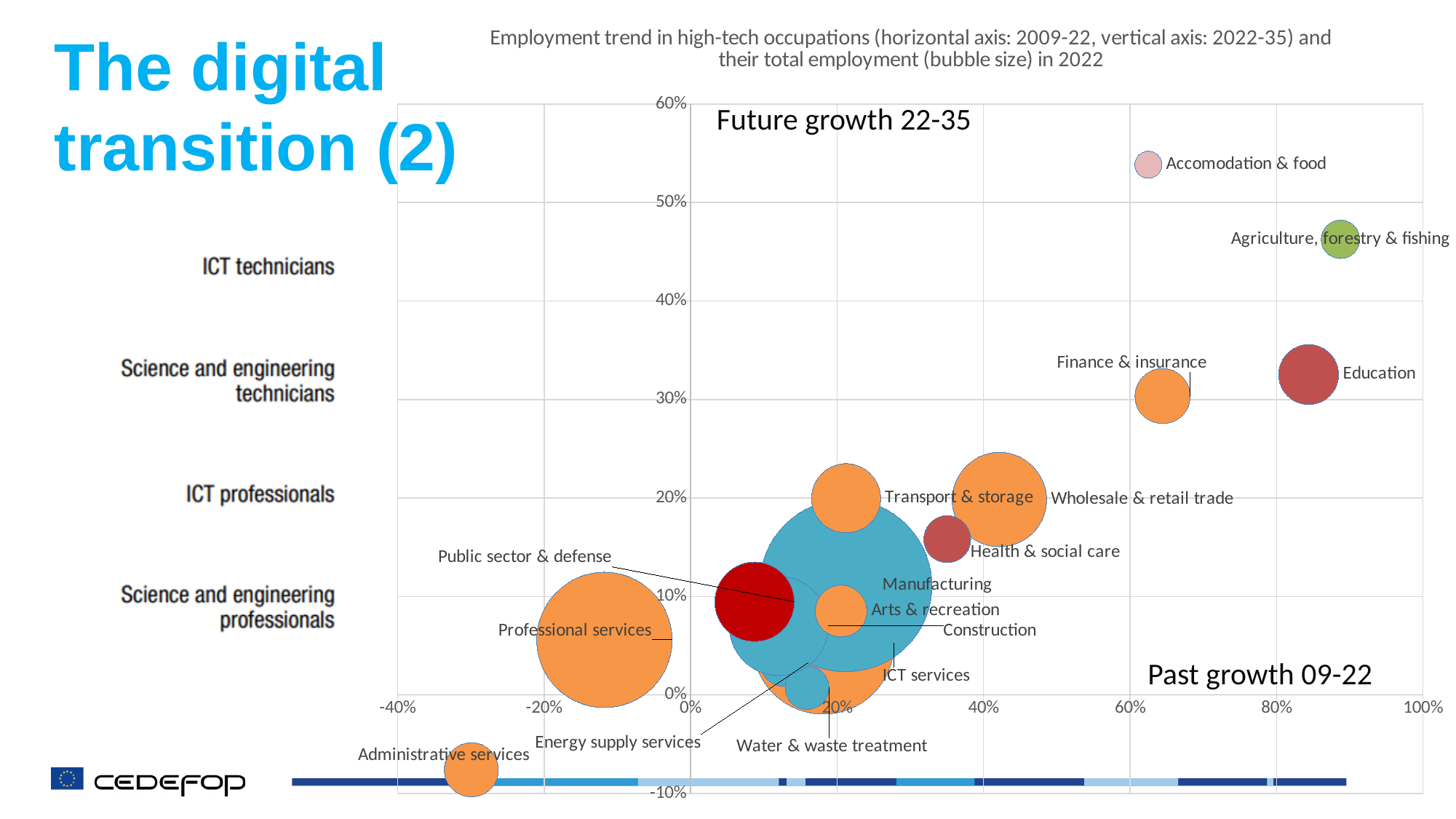
Is the past growth (09-22) for Professional services greater or less than 0%? less Which period does the horizontal axis of the chart cover? 2009-22 (Past growth 09-22) Which has the higher past growth (09-22): Education or Finance & insurance? Education Is the past growth (09-22) for Agriculture, forestry & fishing greater or less than 80%? greater What kind of chart is shown on the slide? Bubble chart Is the future growth (22-35) for Health & social care greater or less than 20%? less What does the bubble size represent in the chart? Total employment in 2022 Which sector has the highest past growth (09-22) in the chart? Agriculture, forestry & fishing Which sector has the largest bubble (total employment in 2022) in the chart? Manufacturing Which sector has the highest future growth (22-35) in the chart? Accomodation & food Which sector has the lowest past growth (09-22) in the chart? Administrative services